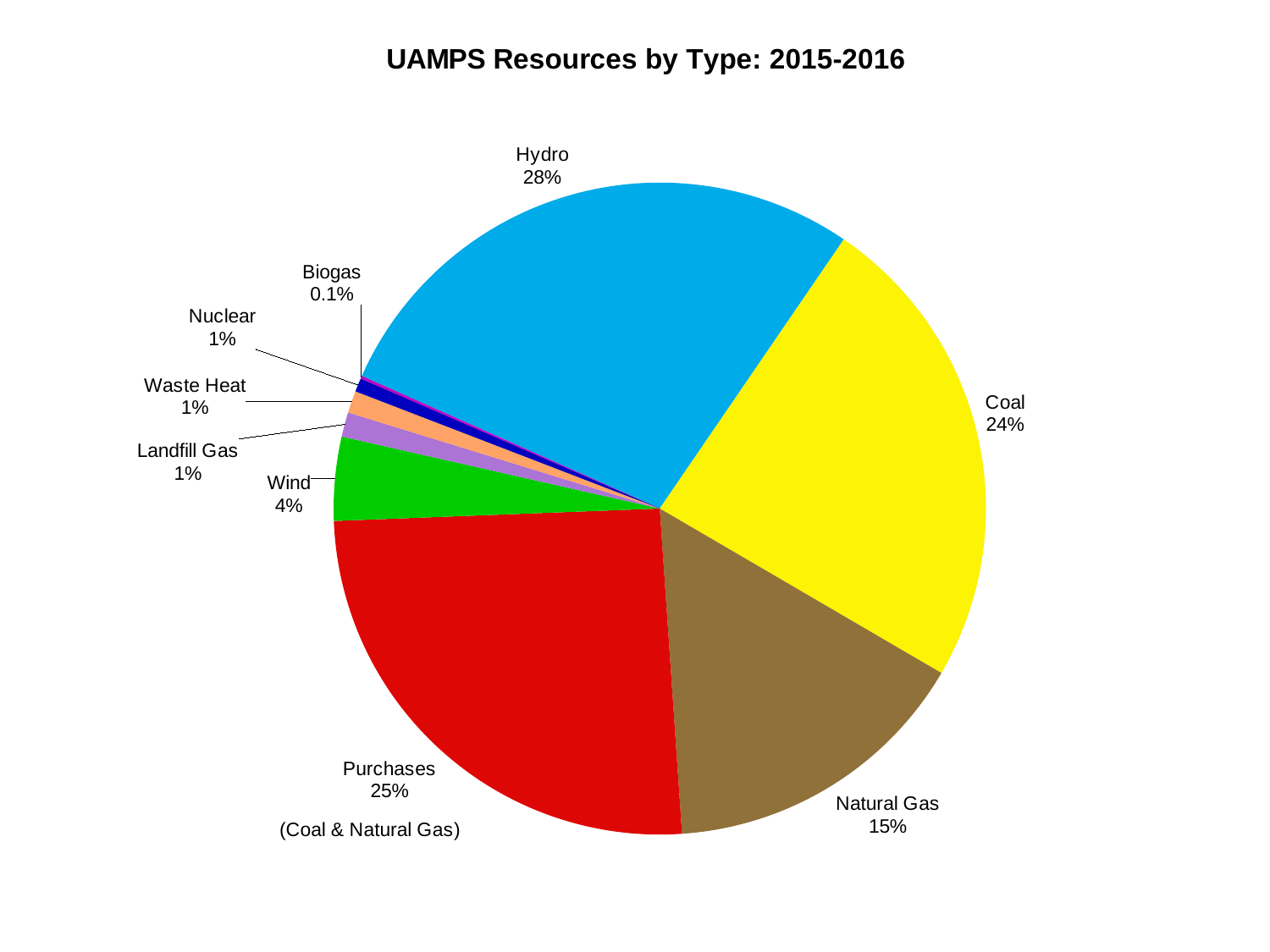
What is the value shown for Biogas? 0.1% How many resource types are shown in the pie chart? 9 Which is larger, the Purchases slice or the Coal slice? Purchases What is the value shown for Coal? 24% What colour is the Wind slice? green What is the value shown for Natural Gas? 15% What is the difference between the Hydro share and the Natural Gas share? 13% Which resource type has the largest slice of the pie? Hydro What kind of chart is shown on the slide? pie chart What share of the pie does Hydro represent? 28% Which resource type has the smallest slice of the pie? Biogas What is the title of the chart? UAMPS Resources by Type: 2015-2016